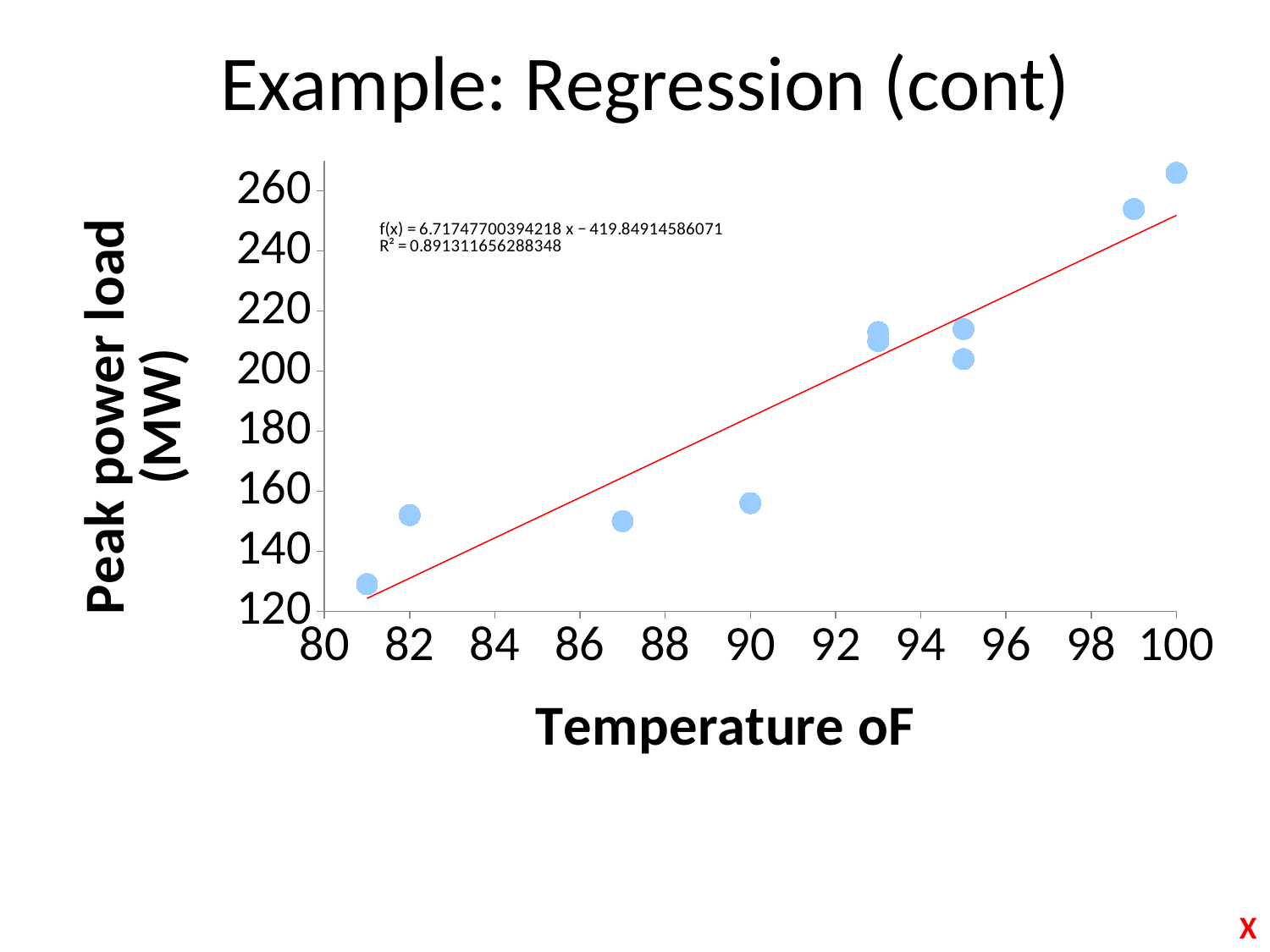
Is the peak power load at a temperature of 100 greater or less than 260? greater Which is larger, the peak power load at temperature 82 or at temperature 99? 99 What is the R² value printed on the chart? 0.891311656288348 Is the peak power load at a temperature of 90 greater or less than 160? less Is the peak power load at a temperature of 87 greater or less than 160? less At which temperature is the lowest peak power load plotted? 81 Do the peak power load values generally rise or fall as temperature increases along the x axis? rise At which temperature is the highest peak power load plotted? 100 What kind of chart is shown on the slide? scatter plot What is the label of the x axis? Temperature oF